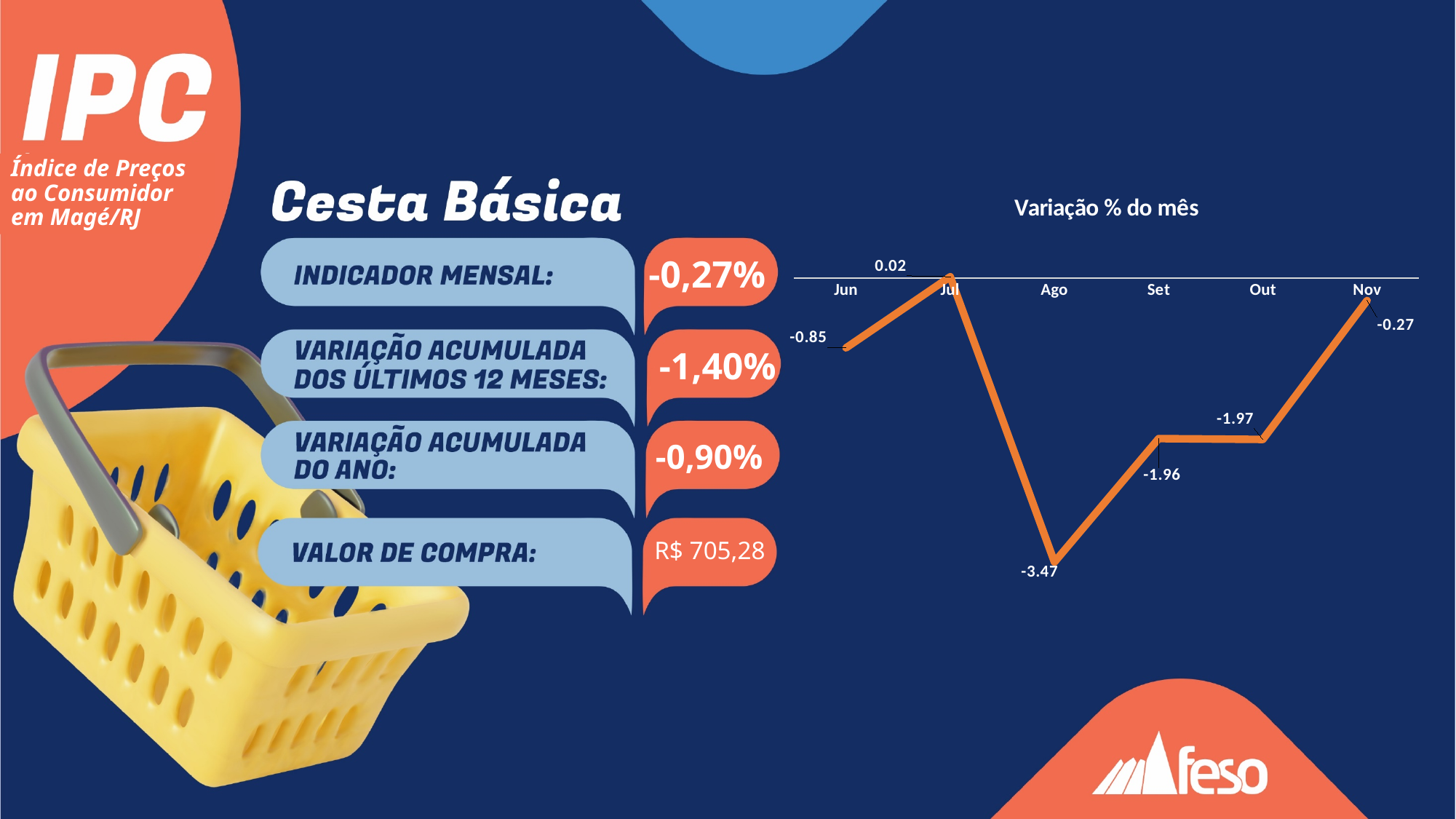
What is the title of the chart? Variação % do mês How many months are plotted on the chart? 6 Is the value for Jun larger or smaller than the value for Ago? larger Which month has the lowest value? Ago Which month has the highest value? Jul What is the difference between the values for Nov and Out? 1.70 What is the value for Nov? -0.27 What type of chart is shown on the slide? line chart What is the value for Jul? 0.02 What is the value for Set? -1.96 What is the value for Ago? -3.47 What is the value for Jun? -0.85